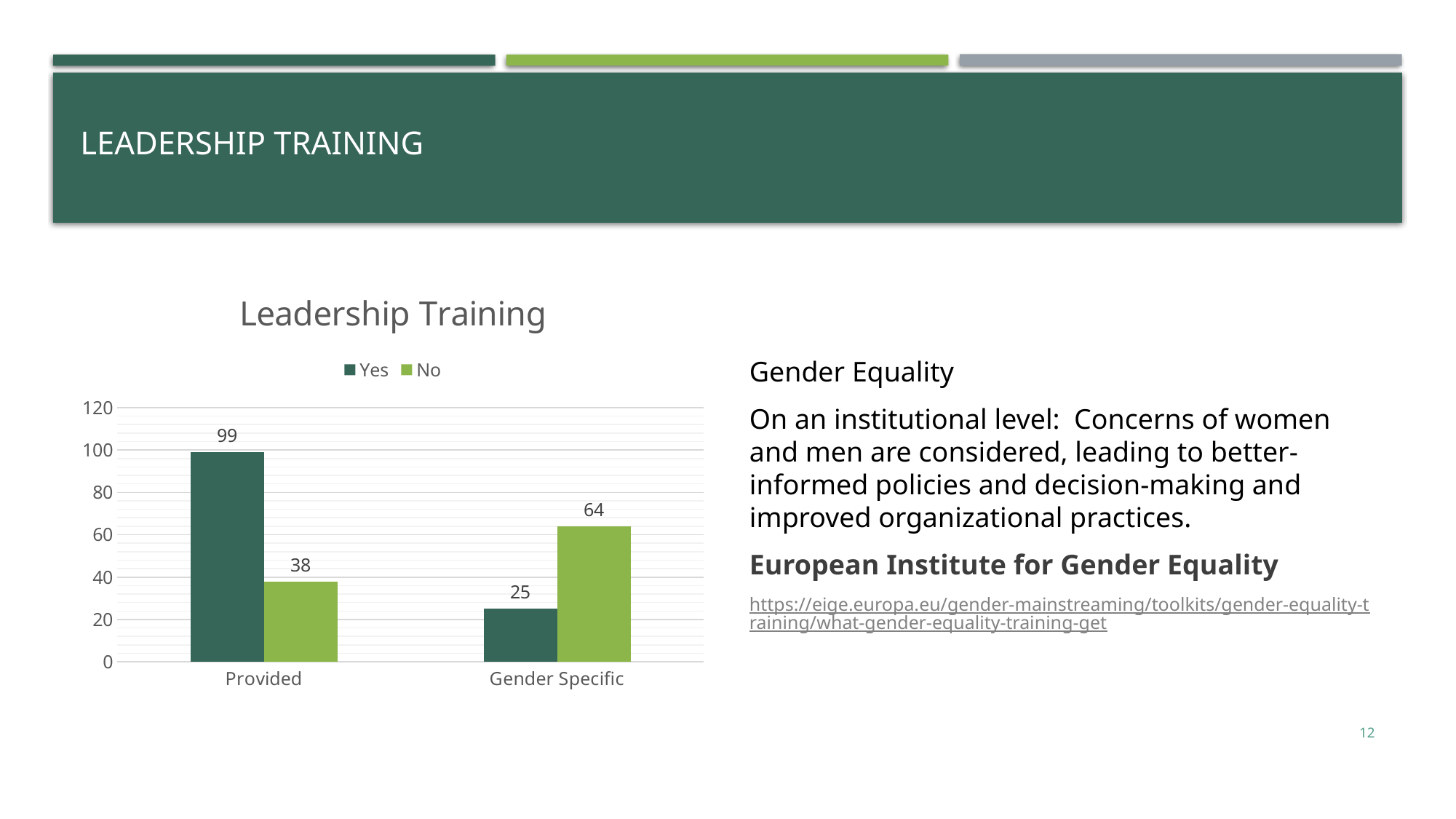
Which category has the lowest 'No' value? Provided What is the 'No' value for Gender Specific? 64 What is the 'Yes' value for Gender Specific? 25 For Gender Specific, which is larger, the 'Yes' value or the 'No' value? No How many categories are shown on the x axis? 2 What is the difference between the 'No' values for Gender Specific and Provided? 26 What kind of chart is shown on the slide? Bar chart How many series does the legend list? 2 What is the 'Yes' value for Provided? 99 Which category has the highest 'Yes' value? Provided What is the difference between the 'Yes' and 'No' values for Provided? 61 What is the 'No' value for Provided? 38